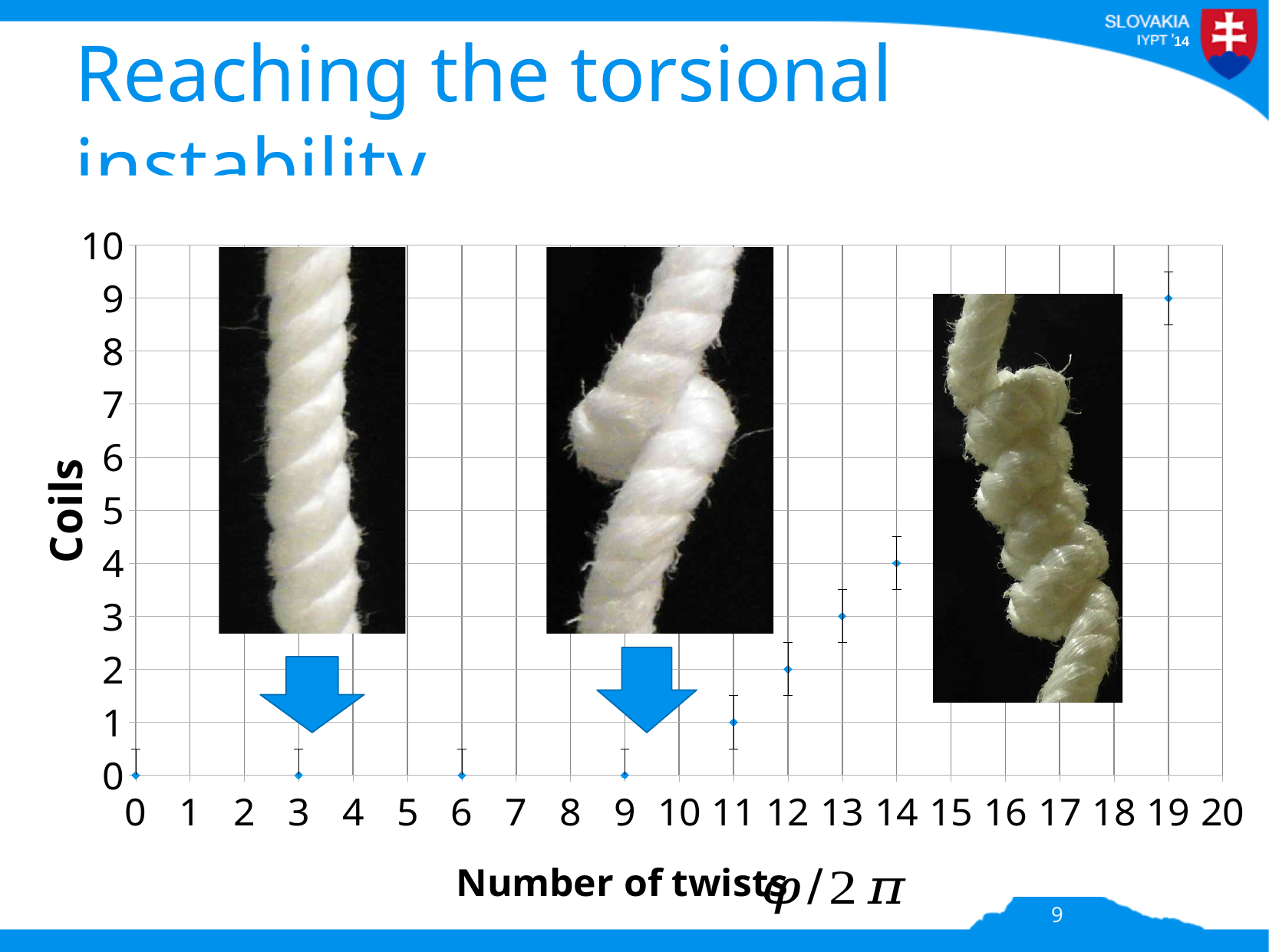
How many coils are plotted at 14 twists? 4 How many coils are plotted at 12 twists? 2 Do the number of coils rise or fall as the number of twists increases? rise Is the number of coils at 19 twists greater or less than 5? greater At which number of twists is the number of coils highest? 19 How many coils are plotted at 9 twists? 0 How many coils are plotted at 11 twists? 1 What is the difference in coils between 19 twists and 14 twists? 5 What is the label of the vertical axis? Coils Which has more coils, 13 twists or 12 twists? 13 twists How many coils are plotted at 19 twists? 9 What kind of chart is shown on the slide? scatter chart